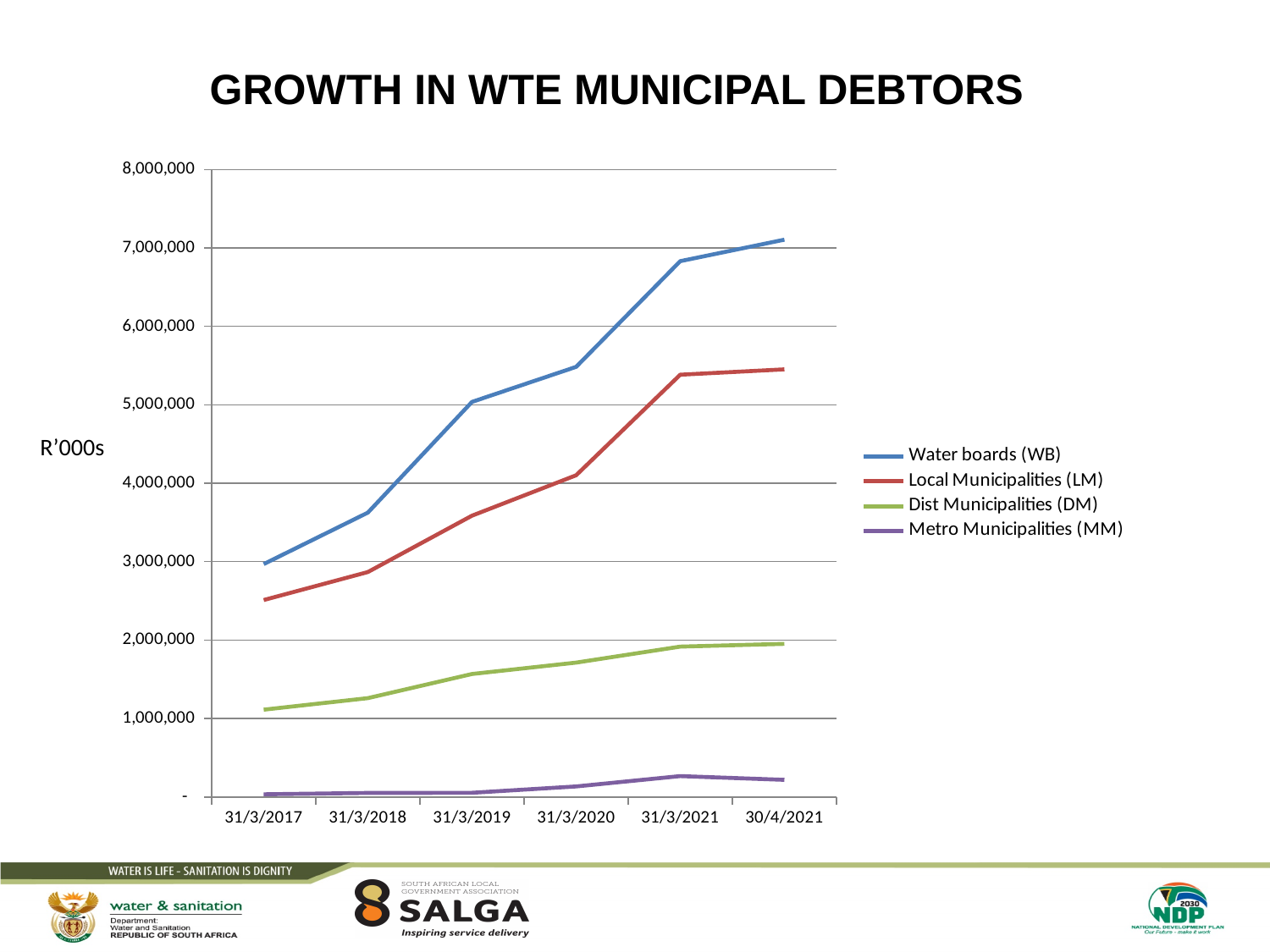
Which series has the lowest value at 31/3/2017? Metro Municipalities (MM) Does the Water boards (WB) line rise or fall from 31/3/2017 to 30/4/2021? rise How many series does the legend list? 4 Is the value for Local Municipalities (LM) at 31/3/2021 greater or less than 5,000,000? greater Which is larger at 31/3/2019: Local Municipalities (LM) or Dist Municipalities (DM)? Local Municipalities (LM) What kind of chart is shown on the slide? line chart How many dates are plotted along the x axis? 6 What is the title of the chart? GROWTH IN WTE MUNICIPAL DEBTORS Which series has the highest value at 30/4/2021? Water boards (WB) Is the value for Water boards (WB) at 31/3/2021 greater or less than 7,000,000? less Is the value for Water boards (WB) at 31/3/2018 greater or less than 4,000,000? less